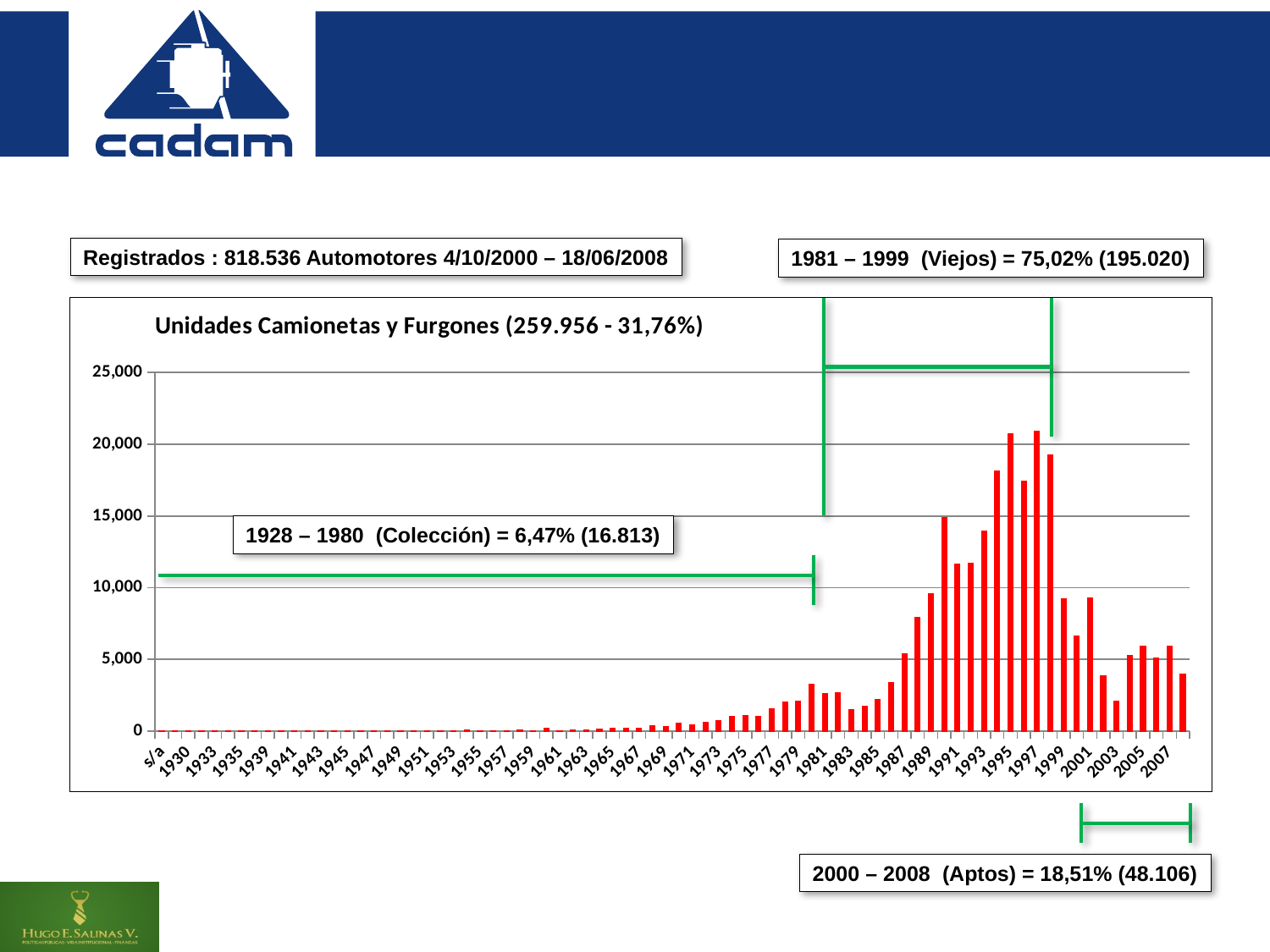
What is the title of the chart? Unidades Camionetas y Furgones (259.956 - 31,76%) What kind of chart is shown on the slide? bar chart Is the value for 1989 greater or less than 10,000? less Is the value for 1997 greater or less than 20,000? greater Do the values generally rise or fall from 1981 to 1997? rise Is the value for 1998 greater or less than 20,000? less Which is larger, the value for 1991 or the value for 1981? 1991 Which is larger, the value for 1997 or the value for 2007? 1997 What colour are the bars in the chart? red